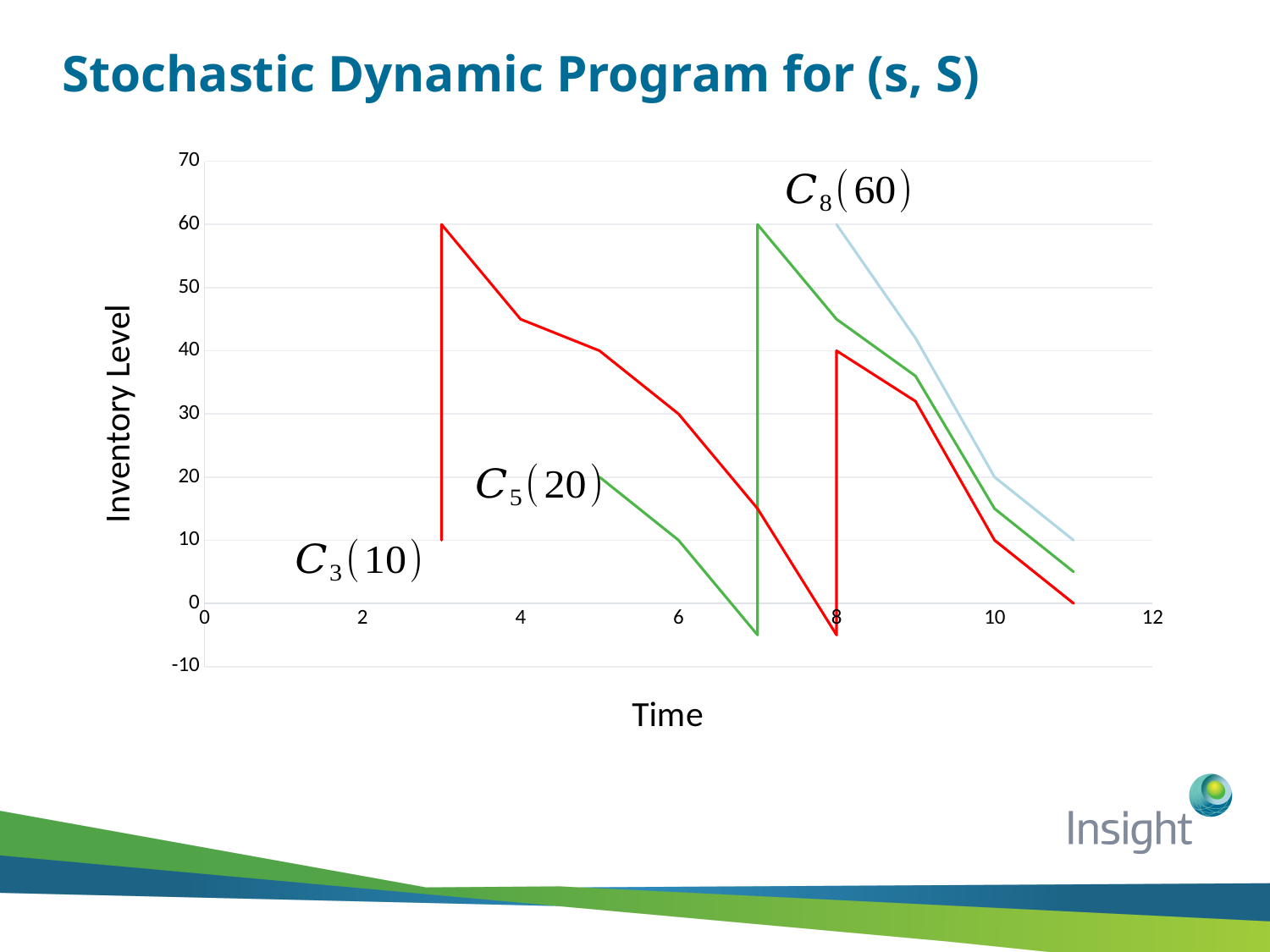
Between time 3 and time 7, does the red line rise or fall? fall How many lines are plotted on the chart? 3 What inventory level does the red line jump up to at time 3? 60 Is the inventory level of the red line at time 4 greater or less than 40? greater What is the inventory level of the red line at time 6? 30 What inventory level does the green line jump up to at time 7? 60 What inventory level does the red line jump up to at time 8? 40 At time 10, which line has the higher inventory level, the green line or the red line? green line What is the title of the vertical axis of the chart? Inventory Level What kind of chart is shown on the slide? line chart What is the title of the horizontal axis of the chart? Time What is the inventory level of the light blue line at time 10? 20